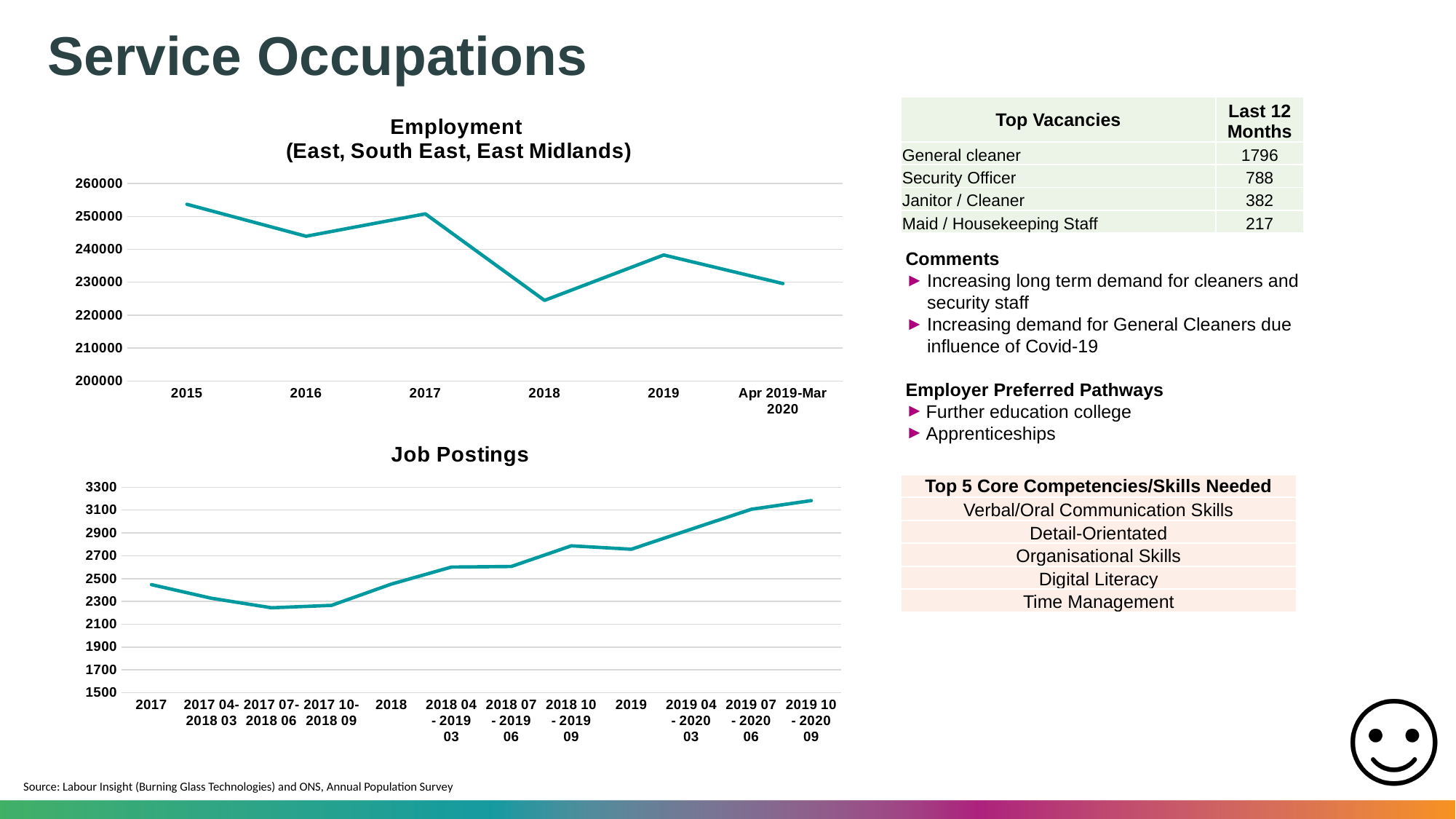
In the Job Postings chart, is the value for 2017 07 - 2018 06 greater or less than 2300? less In the Job Postings chart, is the value for 2019 10 - 2020 09 greater or less than 3100? greater In the Employment (East, South East, East Midlands) chart, which is larger, the value for 2017 or the value for 2019? 2017 In the Employment (East, South East, East Midlands) chart, is the value for 2015 greater or less than 250000? greater In the Employment (East, South East, East Midlands) chart, which year has the lowest employment? 2018 In the Employment (East, South East, East Midlands) chart, which year has the highest employment? 2015 How many data points are plotted in the Employment (East, South East, East Midlands) chart? 6 In the Job Postings chart, which period has the highest number of job postings? 2019 10 - 2020 09 What type of chart is the Employment (East, South East, East Midlands) chart? line chart In the Job Postings chart, do the values generally rise or fall from 2018 to 2019 10 - 2020 09? rise How many periods are shown on the x axis of the Job Postings chart? 12